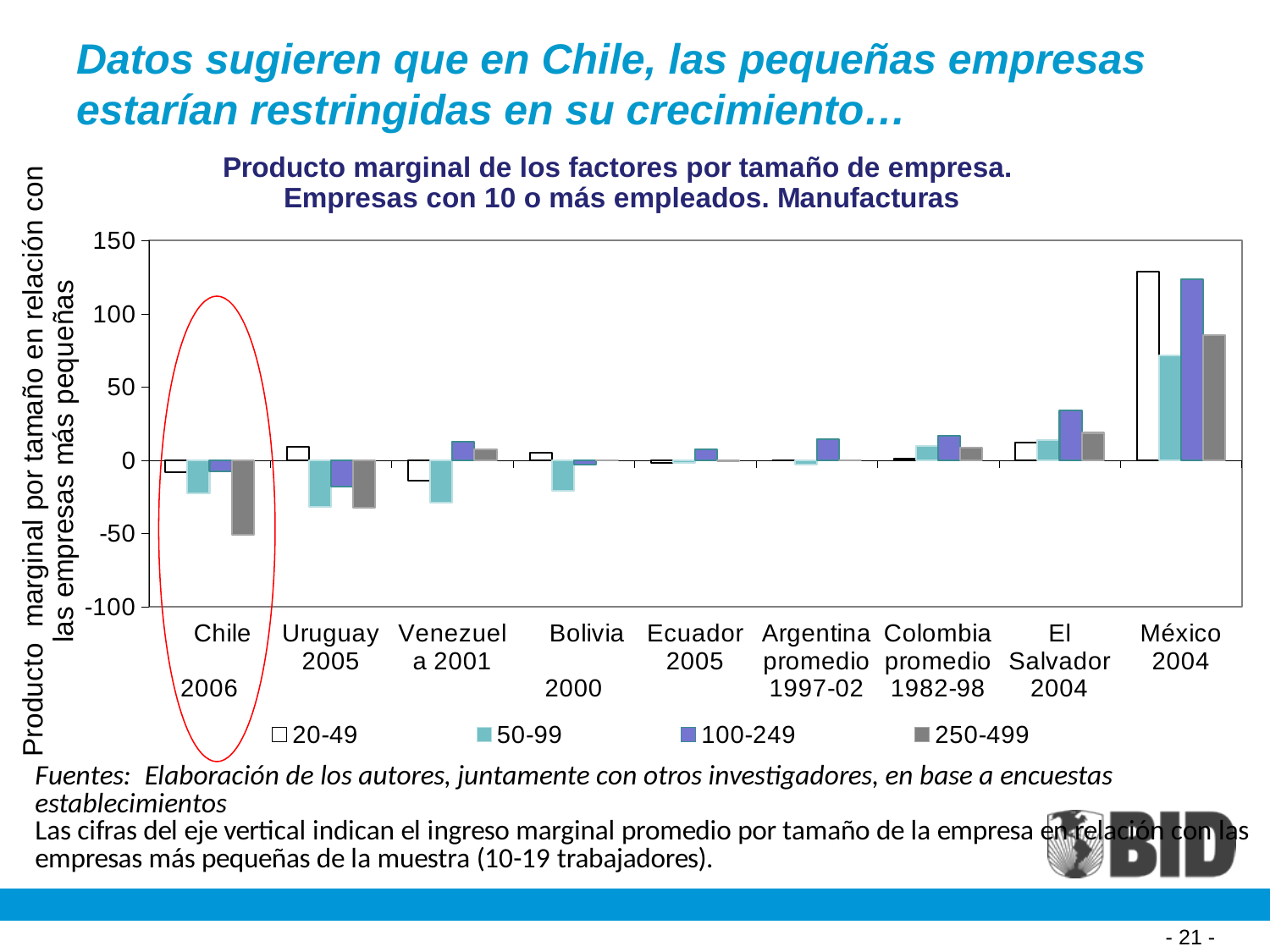
Which country has the lowest value for the 250-499 series? Chile 2006 Which is larger for the 100-249 series: El Salvador 2004 or Colombia promedio 1982-98? El Salvador 2004 Is the value for the 20-49 series in México 2004 greater or less than 100? greater Is the value for the 50-99 series in México 2004 greater or less than 50? greater What are the four legend entries of the chart? 20-49, 50-99, 100-249, 250-499 Which country is circled in red on the chart? Chile 2006 How many series does the legend list? 4 In México 2004, which is larger: the 20-49 series or the 50-99 series? 20-49 Is the value for the 250-499 series in Chile 2006 greater or less than -25? less What kind of chart is shown on the slide? bar chart Which country has the highest value for the 250-499 series? México 2004 How many countries (categories) are shown on the x axis? 9